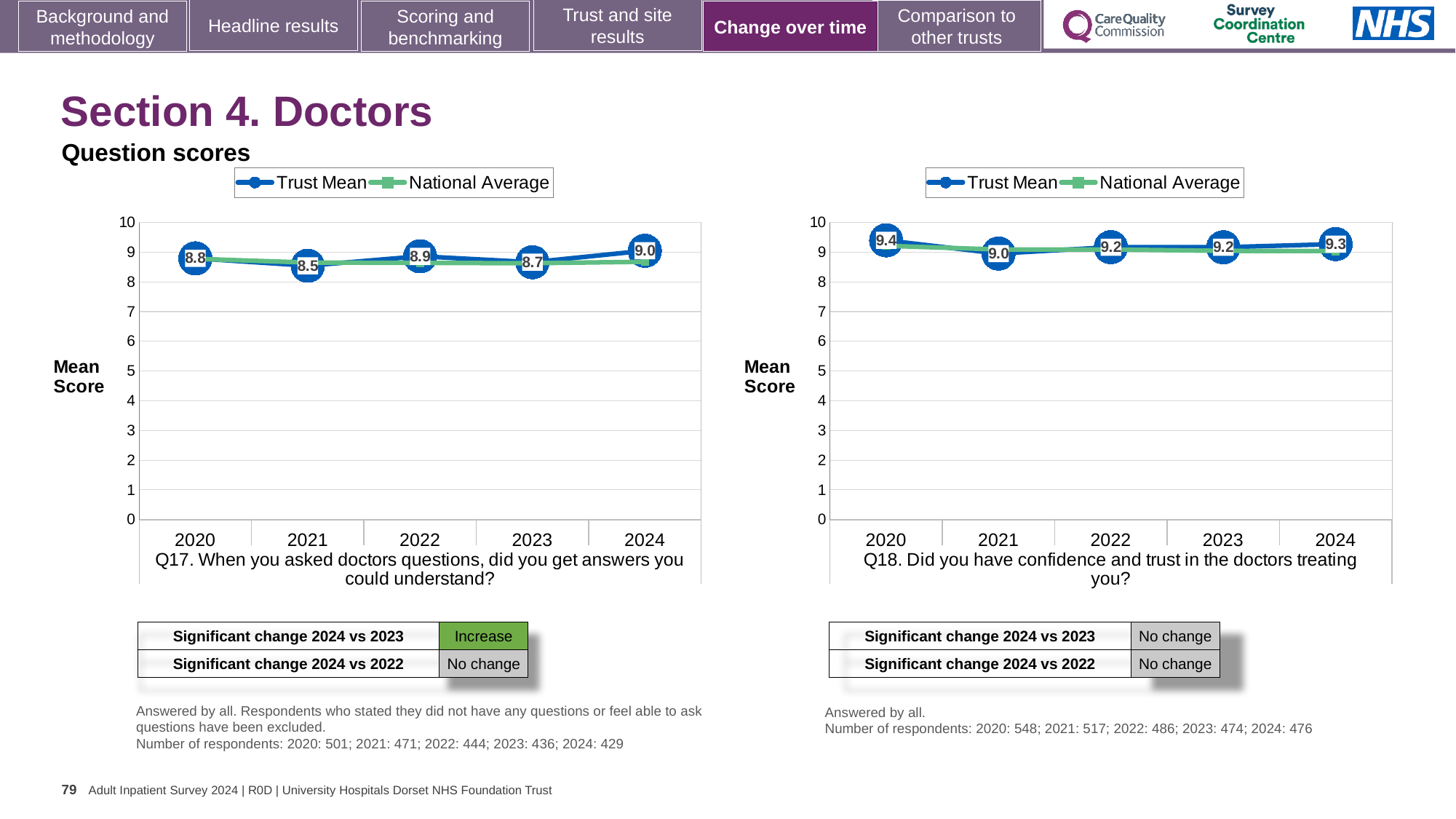
In the Q18 chart, how many series does the legend list? 2 In the Q18 chart, what is the Trust Mean score for 2023? 9.2 In the Q17 chart, what is the difference between the Trust Mean scores for 2024 and 2023? 0.3 In the Q18 chart, is the Trust Mean score for 2021 higher or lower than for 2024? lower What type of chart is used for Q17? Line chart In the Q18 chart, is the National Average for 2020 greater or less than 8? greater In the Q17 chart, which year has the lowest Trust Mean score? 2021 In the Q17 chart, what is the Trust Mean score for 2021? 8.5 In the Q18 chart, which year has the highest Trust Mean score? 2020 In the Q18 chart, what is the Trust Mean score for 2020? 9.4 In the Q17 chart, how many years are plotted on the x axis? 5 In the Q17 chart, what is the Trust Mean score for 2024? 9.0